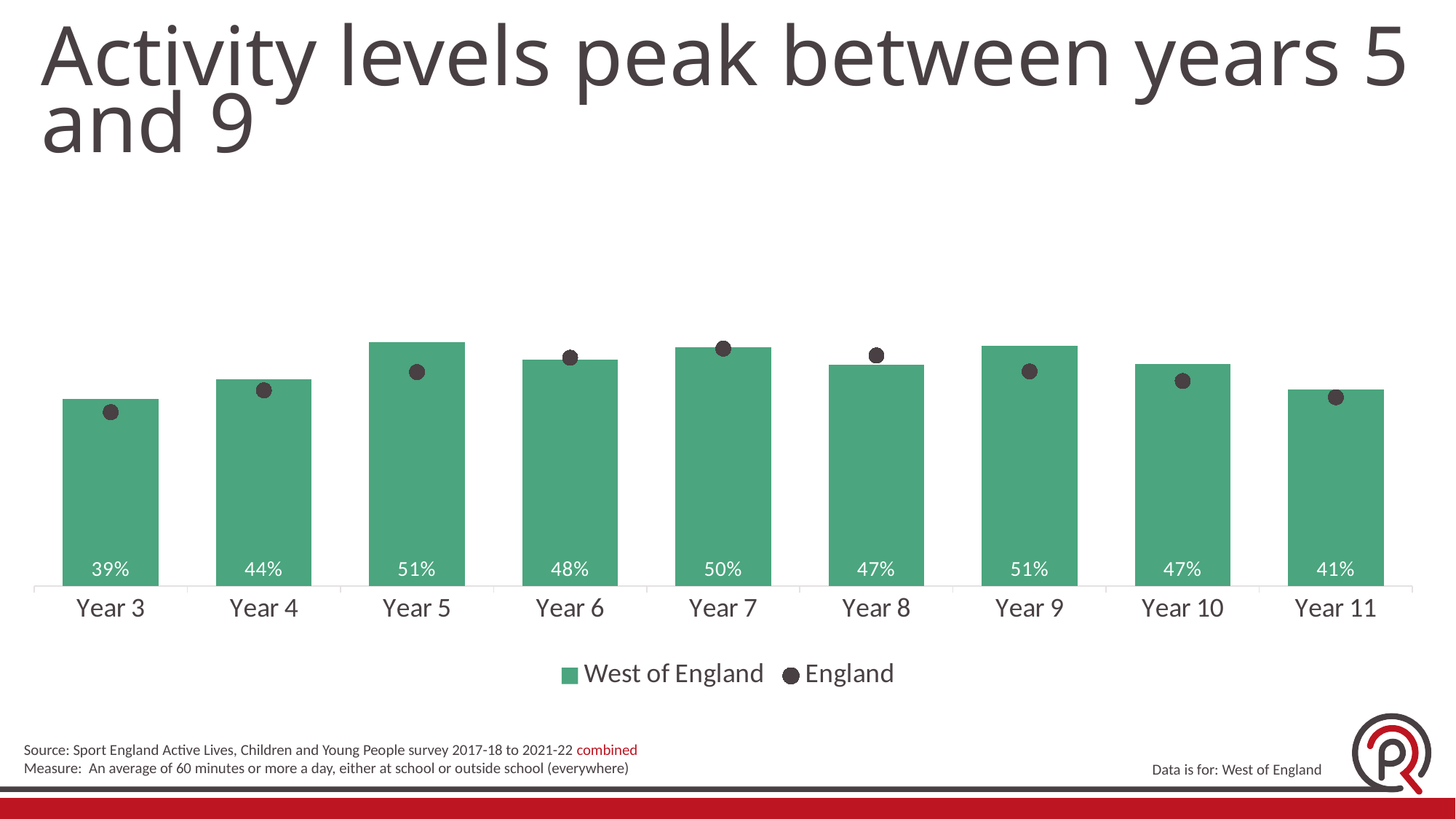
Which has the larger West of England value, Year 4 or Year 10? Year 10 What is the difference between the West of England values for Year 5 and Year 3? 12 percentage points What is the West of England value for Year 11? 41% What is the West of England value for Year 7? 50% Do the West of England values rise or fall from Year 9 to Year 11? Fall How many year groups are shown on the x axis? 9 Which year group has the lowest West of England value? Year 3 What kind of chart is shown on the slide? Bar chart How many series does the legend list? 2 What are the two series named in the legend? West of England and England What is the difference between the West of England values for Year 7 and Year 8? 3 percentage points What is the West of England value for Year 3? 39%